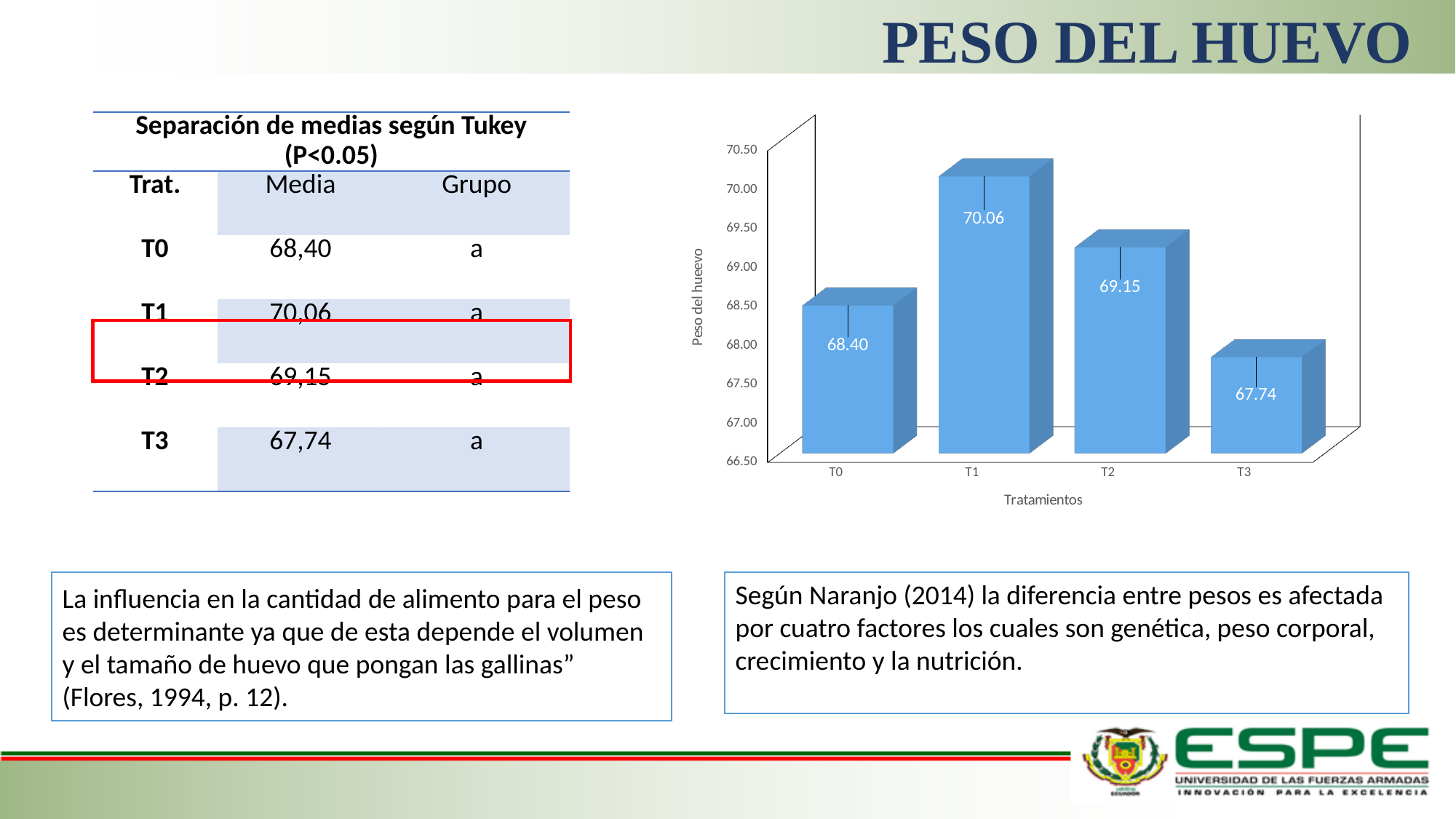
What kind of chart is shown on the slide? bar chart Which is larger in the bar chart, the value for T0 or the value for T2? T2 What is the difference between the values for T2 and T0 in the bar chart? 0.75 What is the value for T1 in the bar chart? 70.06 What is the difference between the values for T1 and T3 in the bar chart? 2.32 Which treatment has the highest egg weight in the bar chart? T1 What is the value for T0 in the bar chart? 68.40 What is the value for T3 in the bar chart? 67.74 How many treatments are shown on the x axis of the bar chart? 4 Is the value for T3 in the bar chart greater or less than 68.00? less Which treatment has the lowest egg weight in the bar chart? T3 What is the label of the y axis of the bar chart? Peso del hueevo